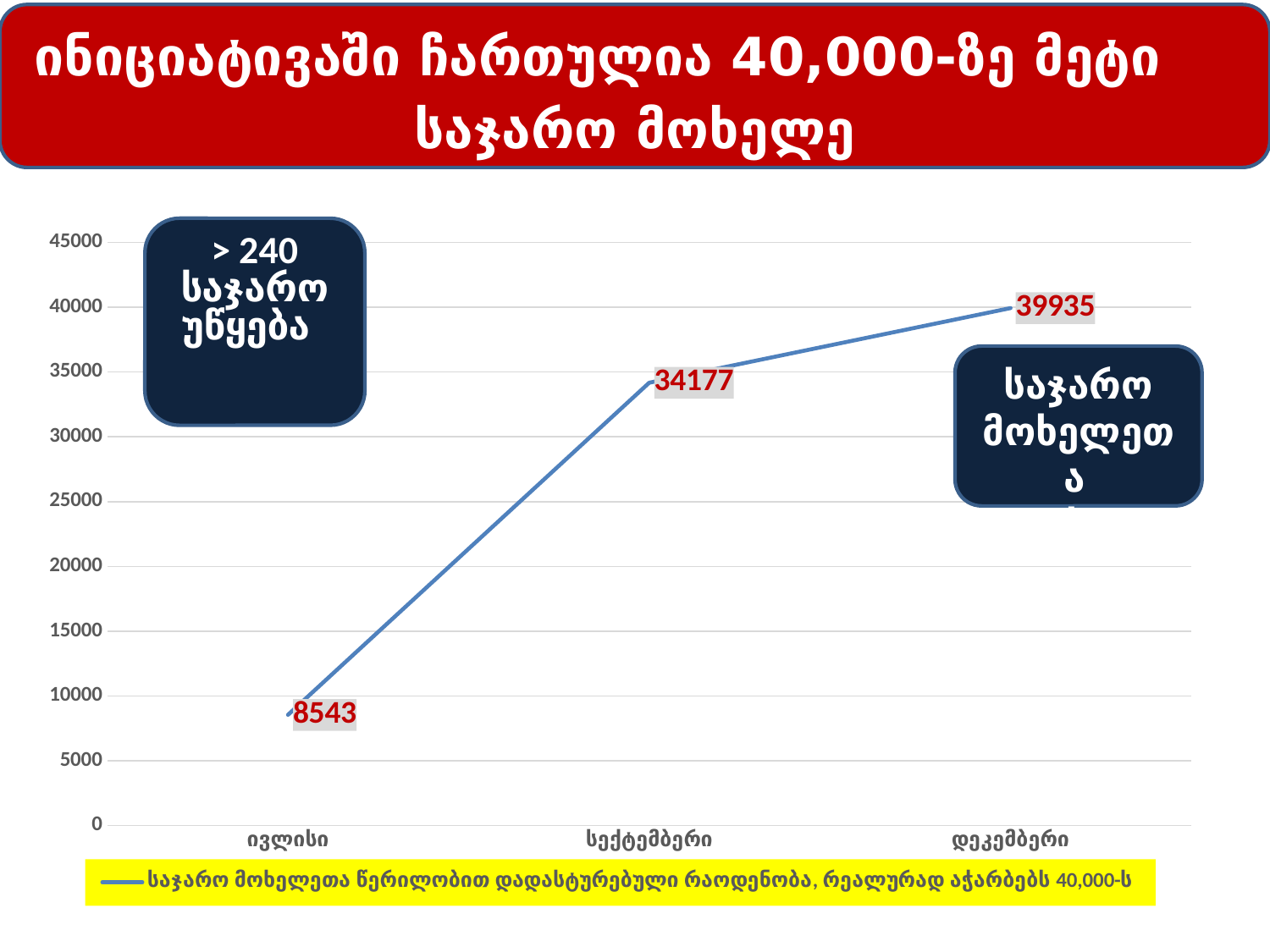
What is the value for სექტემბერი? 34177 Do the values rise or fall from ივლისი to დეკემბერი? rise What is the value for ივლისი? 8543 What is the value for დეკემბერი? 39935 What is the difference between the values for დეკემბერი and სექტემბერი? 5758 Which category has the lowest value? ივლისი Is the value for დეკემბერი greater or less than 35000? greater What is the difference between the values for სექტემბერი and ივლისი? 25634 Which category has the highest value? დეკემბერი Which is larger, the value for ივლისი or the value for სექტემბერი? სექტემბერი How many data points are plotted on the chart? 3 What kind of chart is shown on the slide? line chart